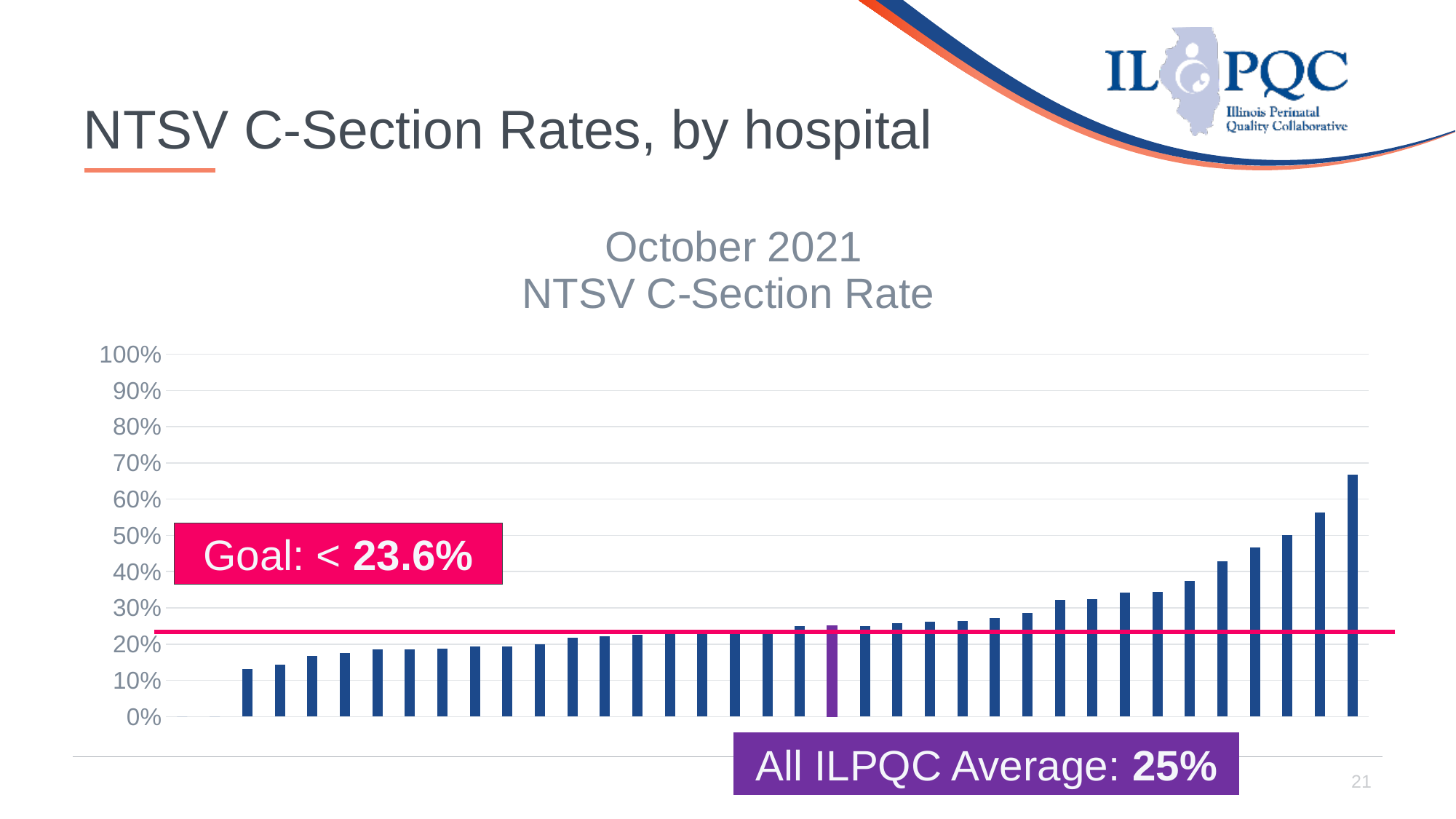
What is the title of the chart? October 2021 NTSV C-Section Rate What is the goal NTSV C-section rate shown on the chart? < 23.6% Which bar is the highest on the chart, the leftmost or the rightmost? rightmost Is the value of the shortest bar greater or less than 20%? less Which is larger, the leftmost bar or the rightmost bar? rightmost bar What kind of chart is shown on the slide? bar chart What colour is the bar representing the All ILPQC Average? purple Is the value of the tallest bar greater or less than 60%? greater Do the bar values rise or fall from left to right along the x axis? rise What is the All ILPQC Average NTSV C-section rate shown on the chart? 25% Is the value of the rightmost bar greater or less than 50%? greater What value does the purple bar represent? 25%